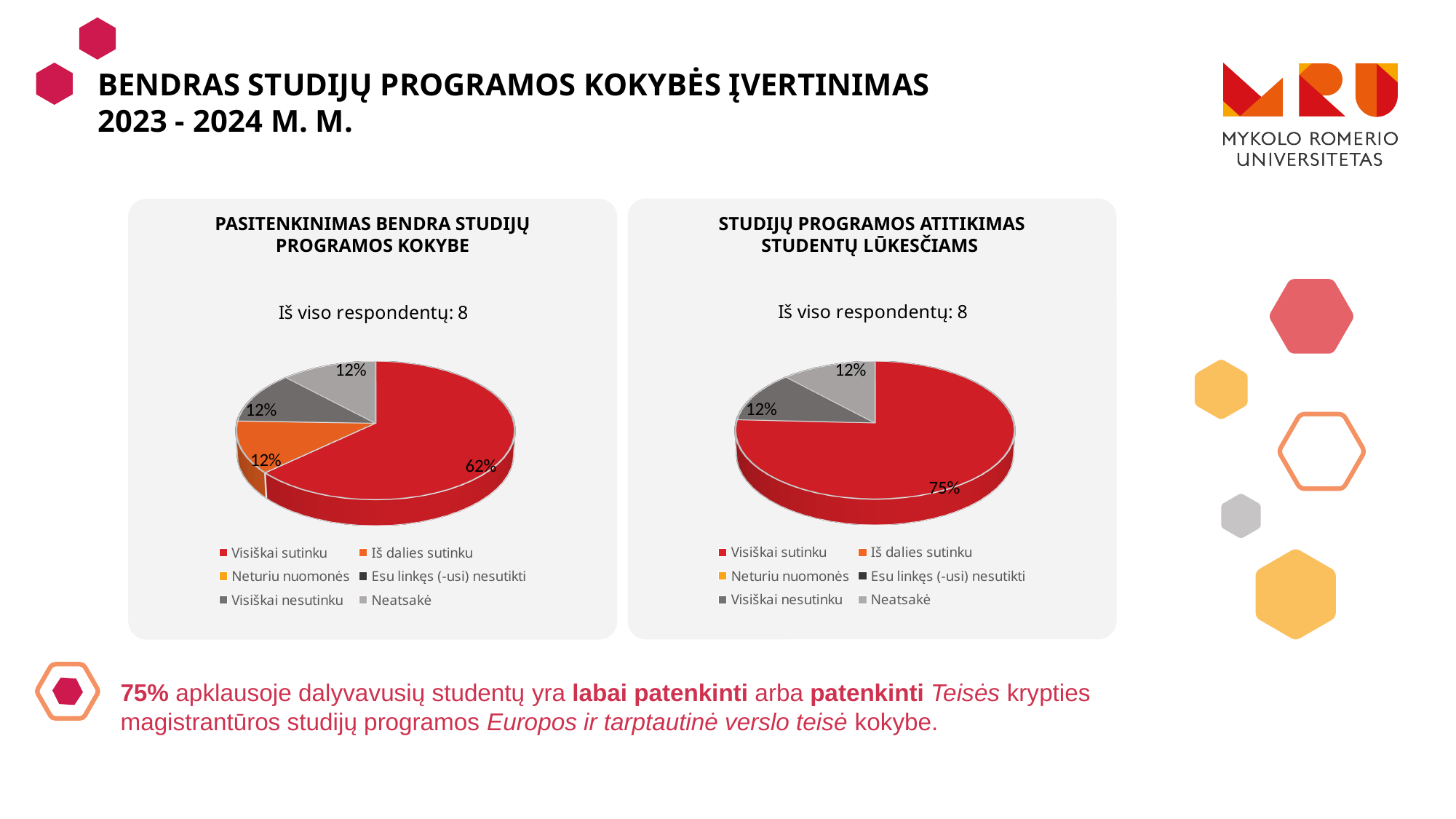
In the left chart, what is the difference between the 'Visiškai sutinku' slice and the 'Iš dalies sutinku' slice? 50% In the left chart, which category has the largest slice? Visiškai sutinku In the chart titled 'STUDIJŲ PROGRAMOS ATITIKIMAS STUDENTŲ LŪKESČIAMS', what share of respondents answered 'Visiškai sutinku'? 75% In the left chart, what share of respondents answered 'Iš dalies sutinku'? 12% How many slices does the pie in the right chart have? 3 How many entries does the legend of the left chart list? 6 How many slices does the pie in the left chart have? 4 In the chart titled 'PASITENKINIMAS BENDRA STUDIJŲ PROGRAMOS KOKYBE', what share of respondents answered 'Visiškai sutinku'? 62% In the right chart, which category has the largest slice? Visiškai sutinku Which chart has the larger 'Visiškai sutinku' share, the left one or the right one? the right one What is the difference between the 'Visiškai sutinku' share in the right chart and the 'Visiškai sutinku' share in the left chart? 13% What type of chart is used in the right chart? pie chart